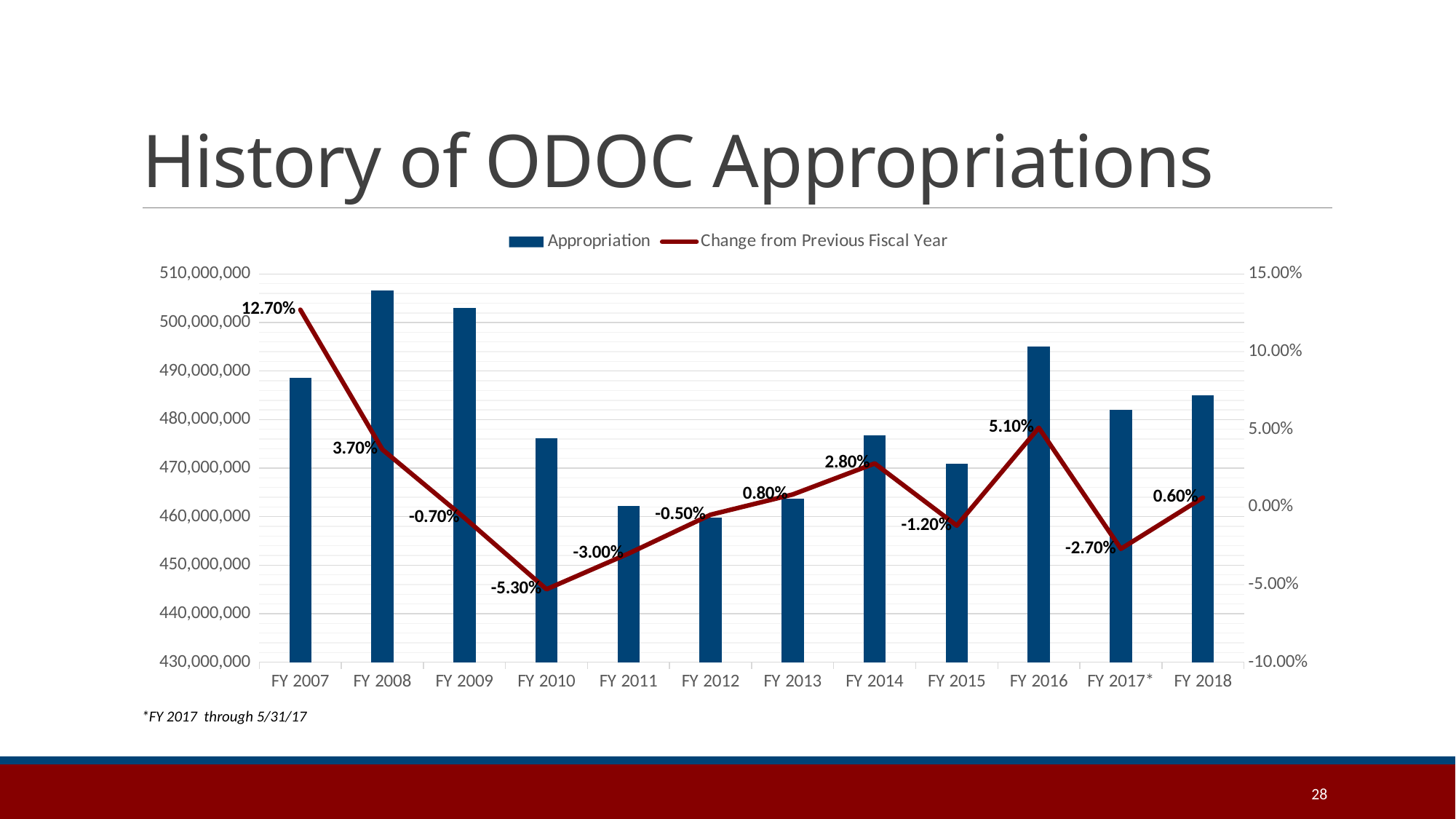
What is the Change from Previous Fiscal Year for FY 2007? 12.70% Does the Appropriation rise or fall from FY 2009 to FY 2012? fall How many fiscal years are shown on the x axis? 12 What is the difference between the Change from Previous Fiscal Year for FY 2016 and FY 2014? 2.30% Which fiscal year has the highest Change from Previous Fiscal Year? FY 2007 What is the Change from Previous Fiscal Year for FY 2010? -5.30% What is the Change from Previous Fiscal Year for FY 2016? 5.10% Is the Appropriation for FY 2012 greater or less than 470,000,000? less Which fiscal year has the lowest Change from Previous Fiscal Year? FY 2010 Is the Appropriation for FY 2008 greater or less than 500,000,000? greater How many series does the legend list? 2 Which is larger, the Change from Previous Fiscal Year for FY 2013 or for FY 2018? FY 2013